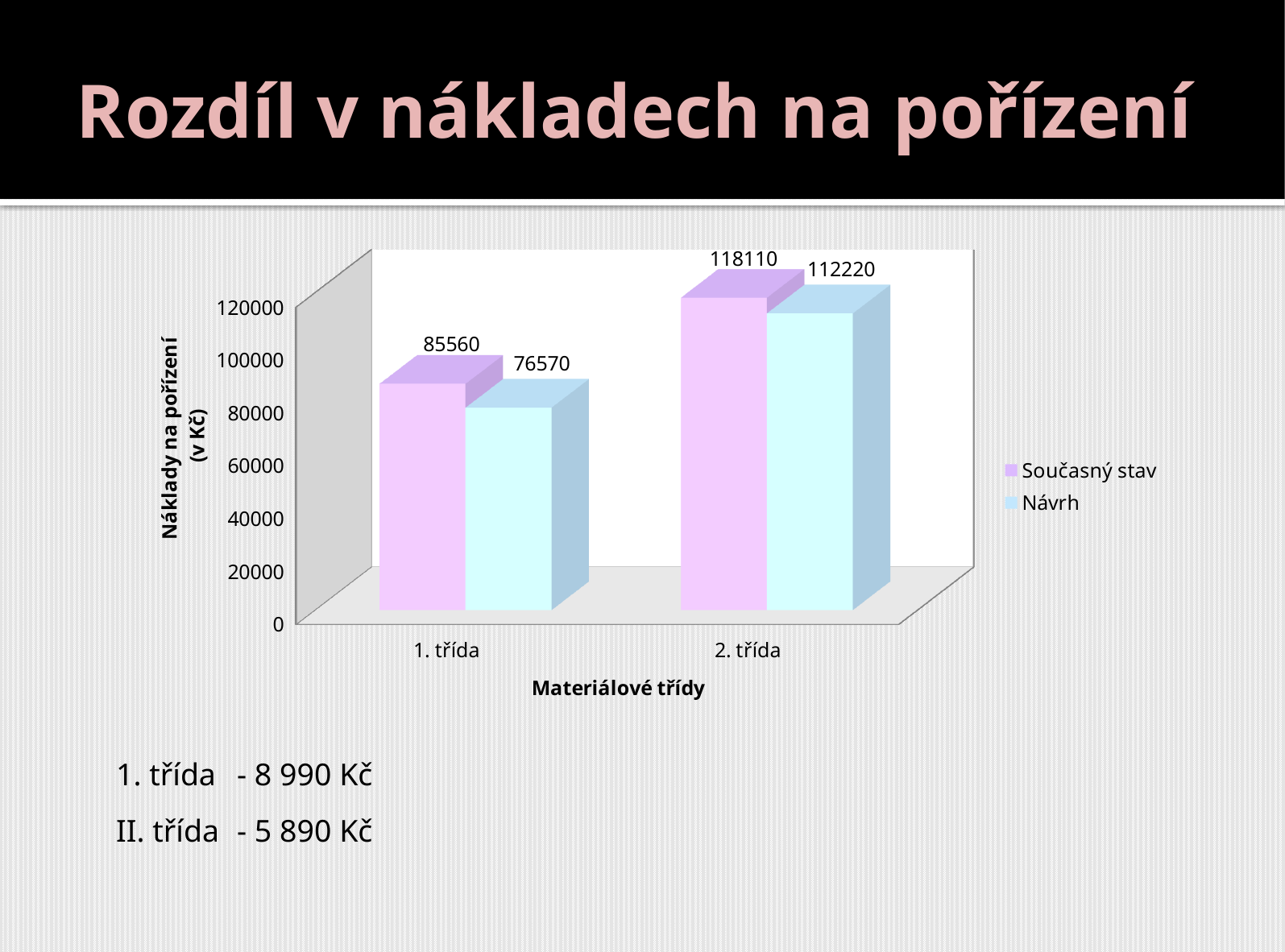
How many categories are shown on the x axis? 2 What is the value for Současný stav in 2. třída? 118110 What is the difference between Současný stav and Návrh in 1. třída? 8990 How many series does the legend list? 2 What is the value for Návrh in 1. třída? 76570 Which category has the highest value for Současný stav? 2. třída Which is larger in 2. třída, Současný stav or Návrh? Současný stav What is the value for Současný stav in 1. třída? 85560 Which category has the lowest value for Návrh? 1. třída What is the difference between Současný stav and Návrh in 2. třída? 5890 What kind of chart is shown on the slide? bar chart What is the value for Návrh in 2. třída? 112220